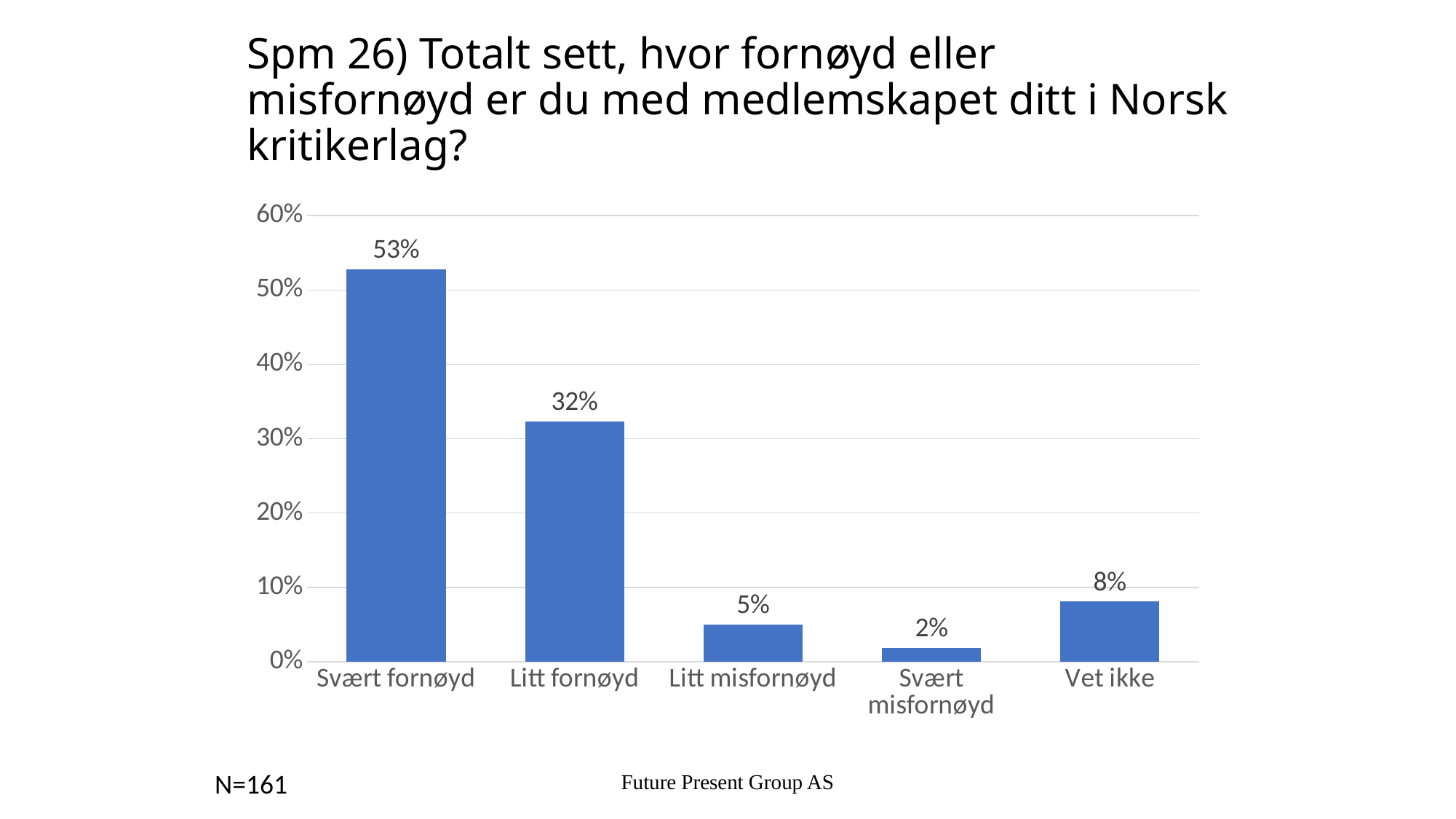
Which category has the highest value? Svært fornøyd Which is larger, the value for Vet ikke or the value for Litt misfornøyd? Vet ikke What is the difference between the values for Svært fornøyd and Litt fornøyd? 21% What is the value for Litt misfornøyd? 5% What is the value for Litt fornøyd? 32% What is the value for Vet ikke? 8% What kind of chart is shown on the slide? Bar chart Is the value for Litt fornøyd greater or less than 30%? greater What is the value for Svært fornøyd? 53% How many categories are shown on the x axis? 5 Which category has the lowest value? Svært misfornøyd What sample size (N) is stated on the slide? N=161